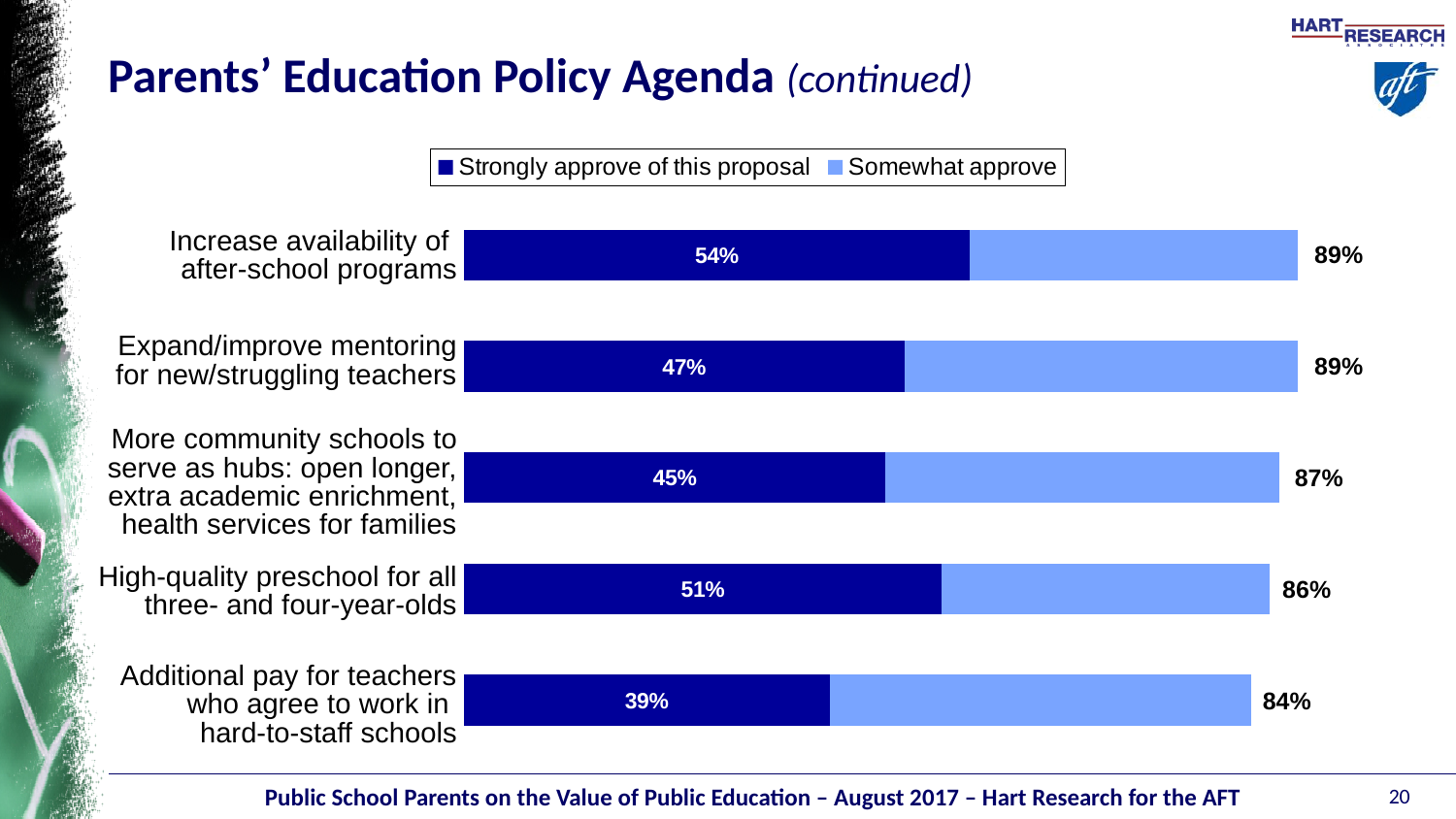
Which proposal has the lowest total approval? Additional pay for teachers who agree to work in hard-to-staff schools What percentage strongly approve of high-quality preschool for all three- and four-year-olds? 51% How many proposals are shown in the chart? 5 Which proposal has the lowest share of parents who strongly approve? Additional pay for teachers who agree to work in hard-to-staff schools Which proposal has the highest share of parents who strongly approve? Increase availability of after-school programs What percentage of parents strongly approve of increasing the availability of after-school programs? 54% What is the difference in percentage points between the strongly approve share for after-school programs (54%) and for additional pay for teachers in hard-to-staff schools (39%)? 15 percentage points How many series does the legend list? 2 What are the two legend entries in the chart? Strongly approve of this proposal; Somewhat approve What is the total approval (strongly plus somewhat) for additional pay for teachers who agree to work in hard-to-staff schools? 84% Which has a higher strongly approve share: expanding mentoring for new/struggling teachers or high-quality preschool for all three- and four-year-olds? High-quality preschool for all three- and four-year-olds What type of chart is shown on the slide? Stacked bar chart